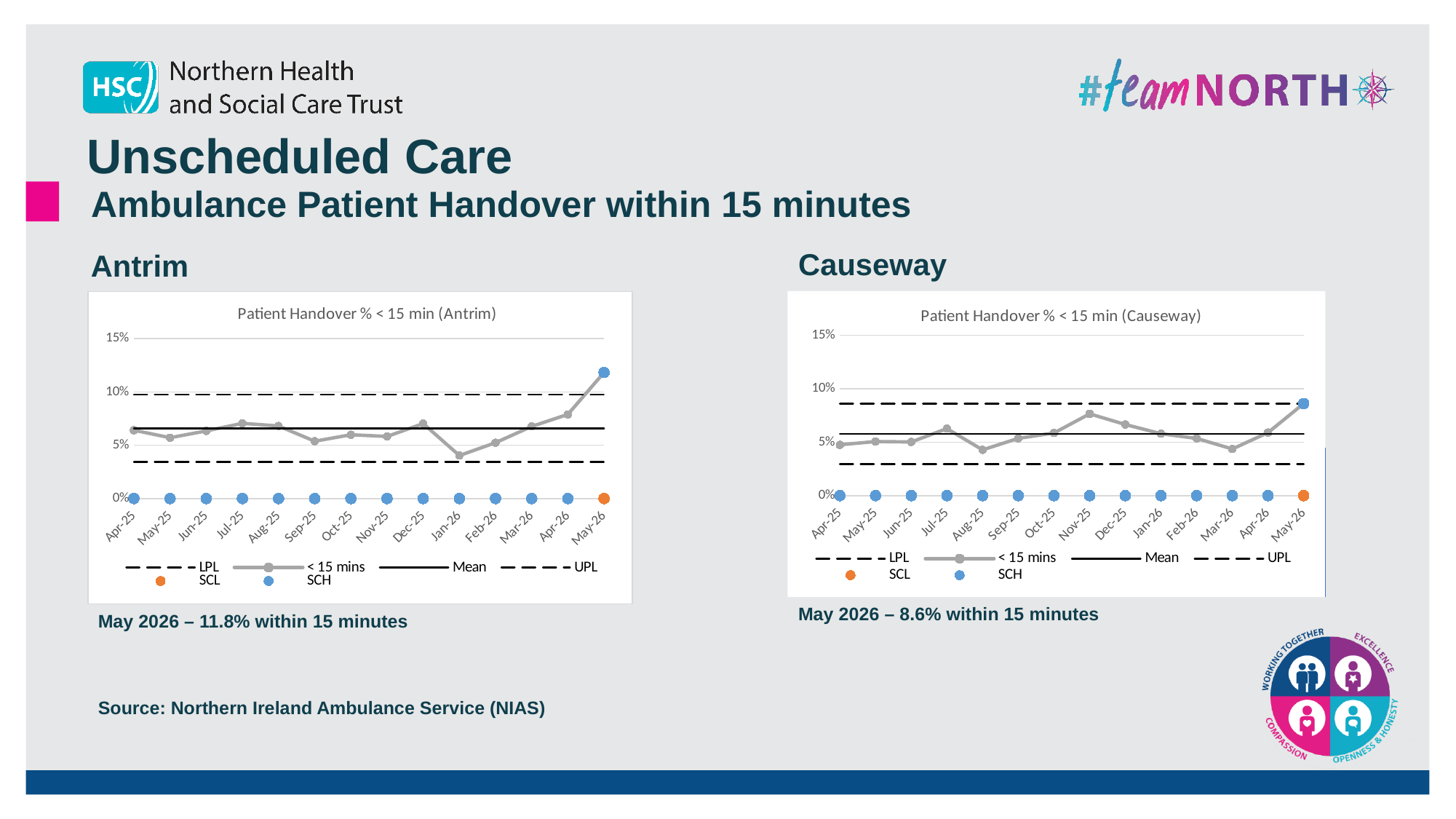
In the Antrim chart, which month has the lowest < 15 mins value? Jan-26 What is the difference between the May-26 value in the Antrim chart and the May-26 value in the Causeway chart? 3.2 percentage points In the Causeway chart, how many months are plotted on the x axis? 14 Which is larger, the May-26 value in the Antrim chart or the May-26 value in the Causeway chart? Antrim In the Causeway chart, what is the value for May-26? 8.6% In the Antrim chart, what is the value for May-26? 11.8% In the Antrim chart, which month has the highest < 15 mins value? May-26 In the Causeway chart, which month has the highest < 15 mins value? May-26 In the Antrim chart, is the < 15 mins value for Jan-26 greater or less than 5%? less In the Antrim chart, how many series does the legend list? 6 What kind of chart is the Antrim chart? Line chart In the Antrim chart, does the < 15 mins line rise or fall from Jan-26 to May-26? Rise